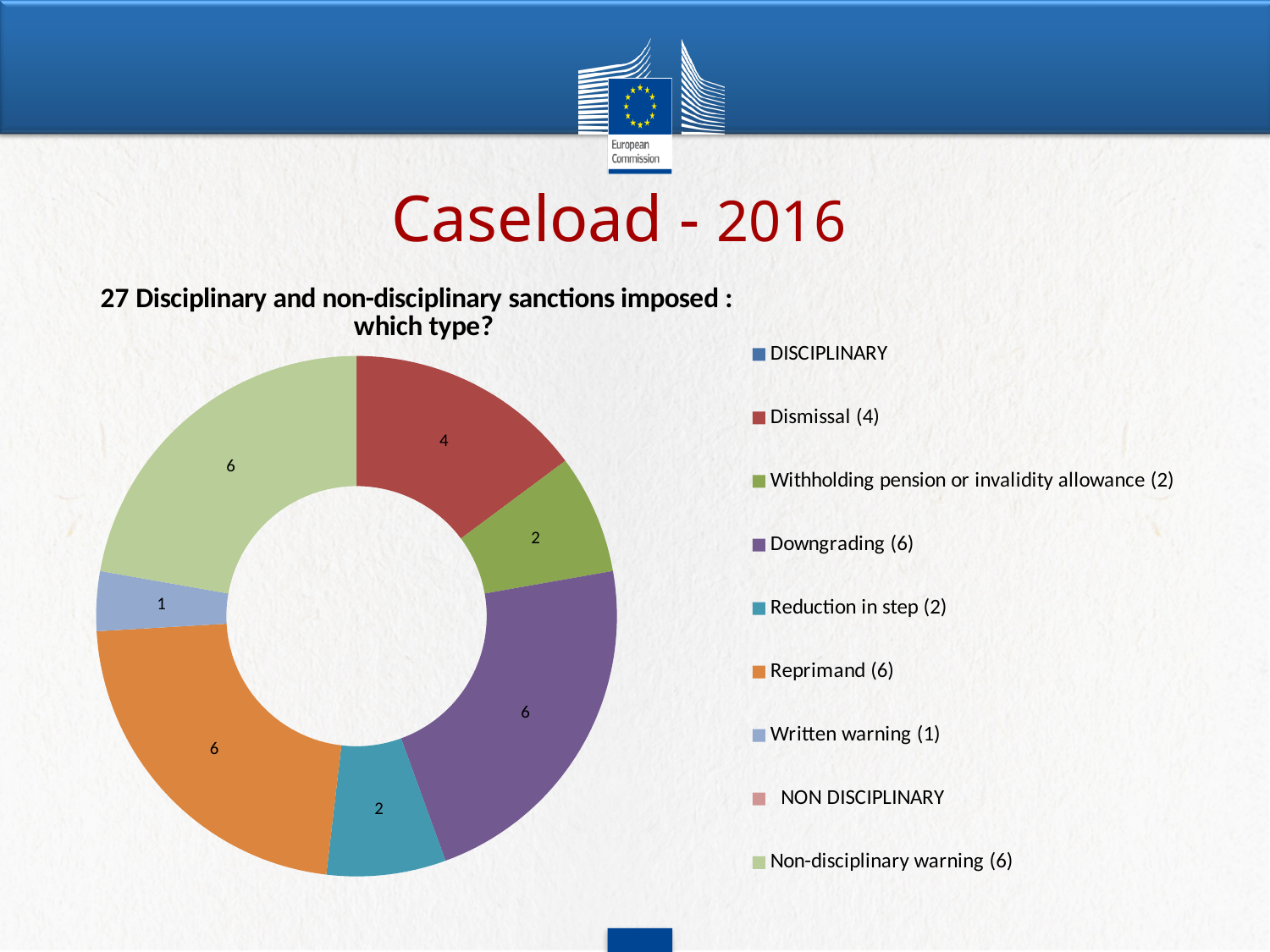
Which category has the lowest value? Written warning Which is larger, the value for Dismissal or the value for Reduction in step? Dismissal What is the value for Dismissal? 4 What is the value for Written warning? 1 What is the value for Downgrading? 6 What is the value for Non-disciplinary warning? 6 How many entries does the legend list? 9 How many slices does the chart have? 7 What type of chart is shown on the slide? Doughnut (pie) chart What is the difference between the values for Dismissal and Written warning? 3 What is the value for Reduction in step? 2 What is the title of the chart? 27 Disciplinary and non-disciplinary sanctions imposed : which type?